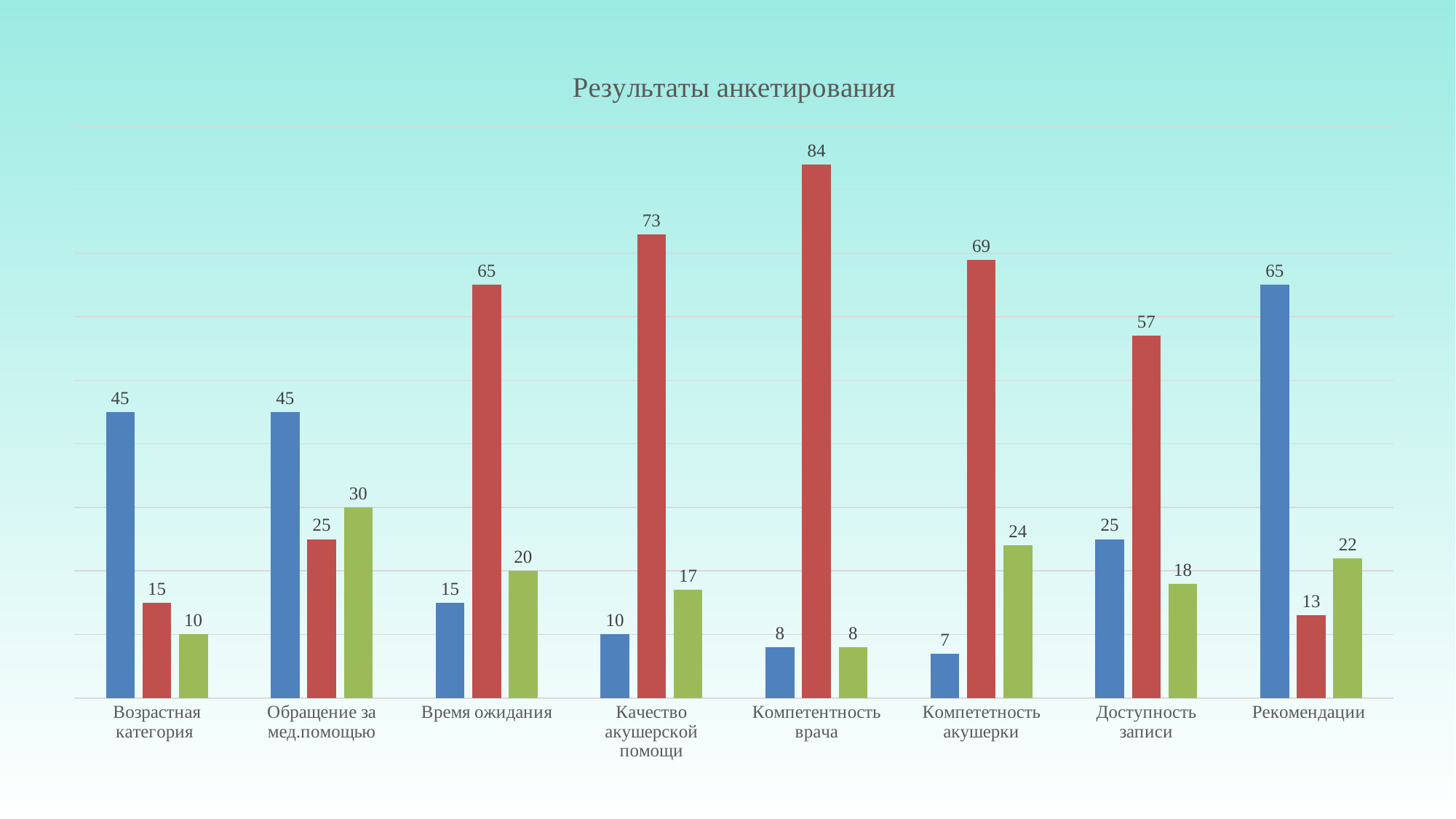
What is the value of the green bar for "Обращение за мед.помощью"? 30 Which category has the highest red bar? Компетентность врача How many categories are shown on the x axis? 8 How many bars are shown for each category? 3 What is the value of the blue bar for "Рекомендации"? 65 What is the total of the three bars for "Возрастная категория"? 70 What kind of chart is shown on the slide? bar chart What is the title of the chart? Результаты анкетирования What is the value of the red bar for "Компетентность врача"? 84 Which category has the lowest blue bar? Компететность акушерки Which is larger for "Доступность записи": the blue bar or the green bar? the blue bar What is the difference between the red bar for "Качество акушерской помощи" and the red bar for "Время ожидания"? 8